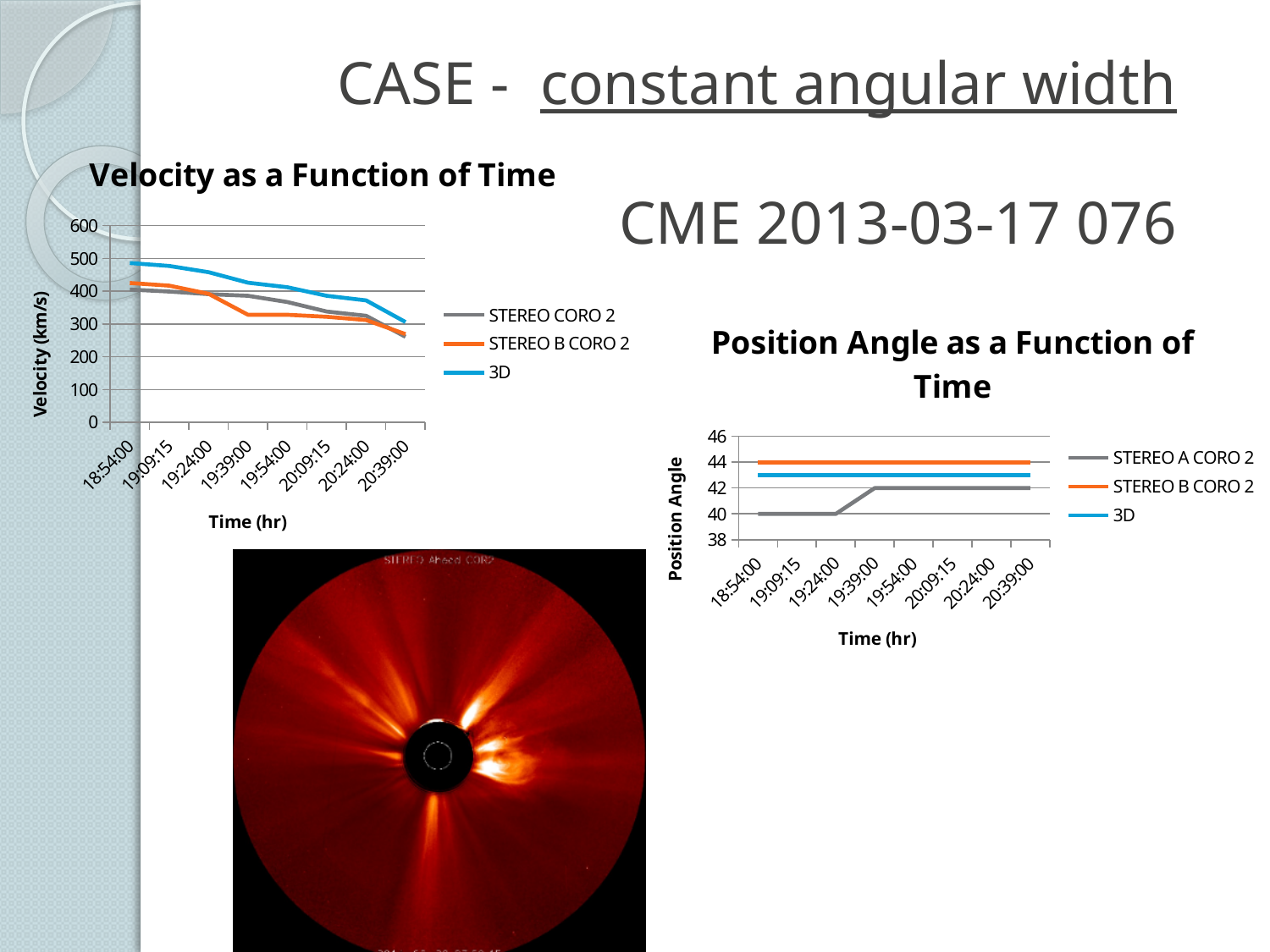
What is the y-axis label of the "Velocity as a Function of Time" chart? Velocity (km/s) In the "Velocity as a Function of Time" chart, does the 3D series rise or fall over time? Fall In the "Velocity as a Function of Time" chart, is the STEREO B CORO 2 value at 20:39:00 greater or less than 300? less How many series does the legend of the "Velocity as a Function of Time" chart list? 3 In the "Velocity as a Function of Time" chart, is the 3D value at 18:54:00 greater or less than 400? greater In the "Velocity as a Function of Time" chart, which series has the highest velocity at 18:54:00? 3D How many time labels are shown on the x axis of the "Velocity as a Function of Time" chart? 8 In the "Position Angle as a Function of Time" chart, what is the STEREO A CORO 2 position angle at 18:54:00? 40 What kind of chart is the "Velocity as a Function of Time" chart? Line chart In the "Position Angle as a Function of Time" chart, which series has the highest position angle? STEREO B CORO 2 In the "Position Angle as a Function of Time" chart, what is the STEREO A CORO 2 position angle at 20:39:00? 42 In the "Position Angle as a Function of Time" chart, what is the position angle of the STEREO B CORO 2 series? 44